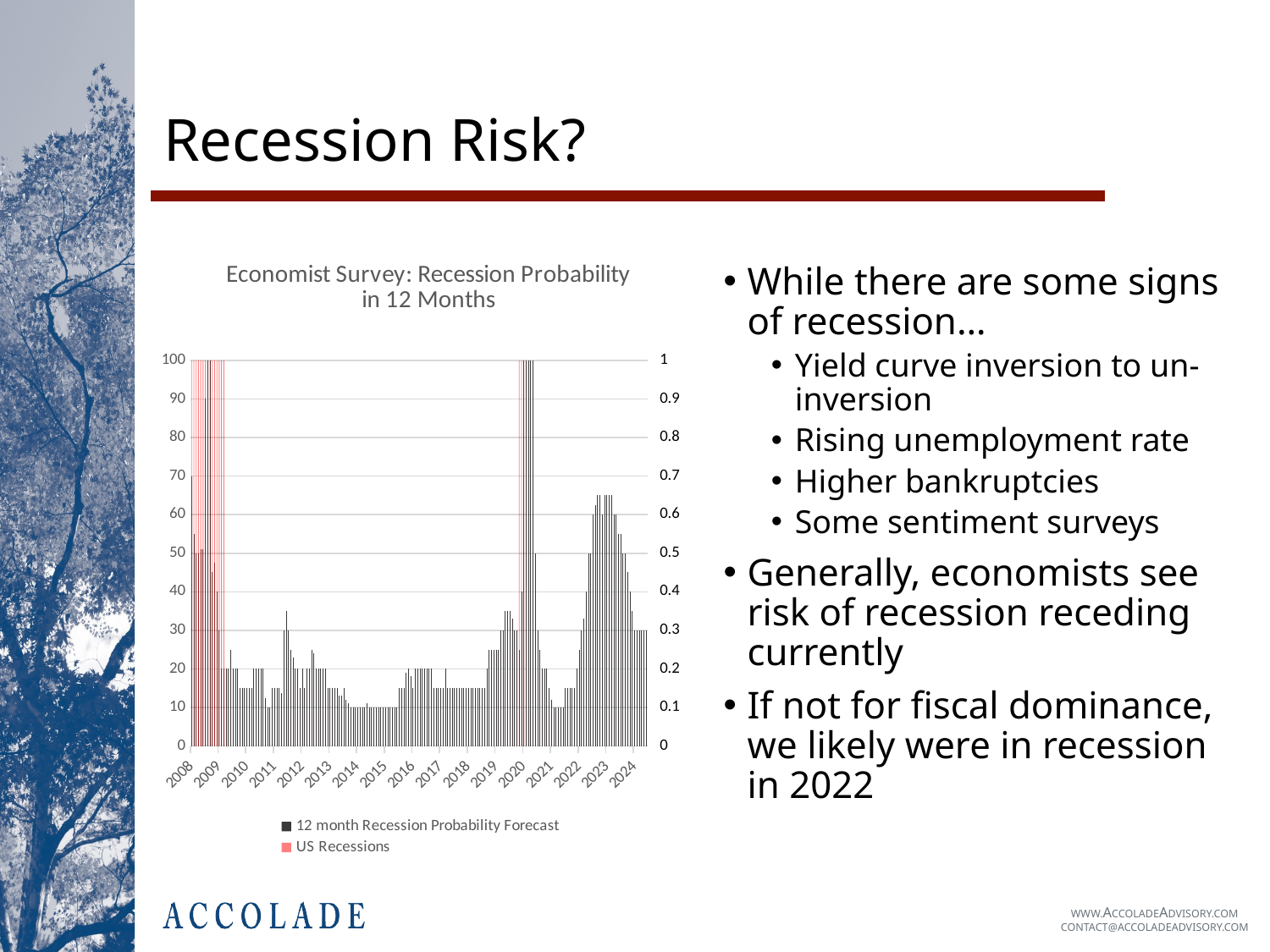
Which series in the legend is shown in red? US Recessions Is the value of the 12 month Recession Probability Forecast around 2015 greater or less than 20? less How many year labels are shown on the x axis? 17 Is the 12 month Recession Probability Forecast higher at its 2023 peak or at its 2012 peak? 2023 peak Is the value of the 12 month Recession Probability Forecast at the start of 2008 greater or less than 40? greater Is the peak value of the 12 month Recession Probability Forecast in 2020 greater or less than 90? greater How many series does the chart legend list? 2 What is the title of the chart? Economist Survey: Recession Probability in 12 Months Does the 12 month Recession Probability Forecast rise or fall from 2021 to 2023? rise What kind of chart is shown on the slide? bar chart Does the 12 month Recession Probability Forecast rise or fall from its 2023 peak to 2024? fall